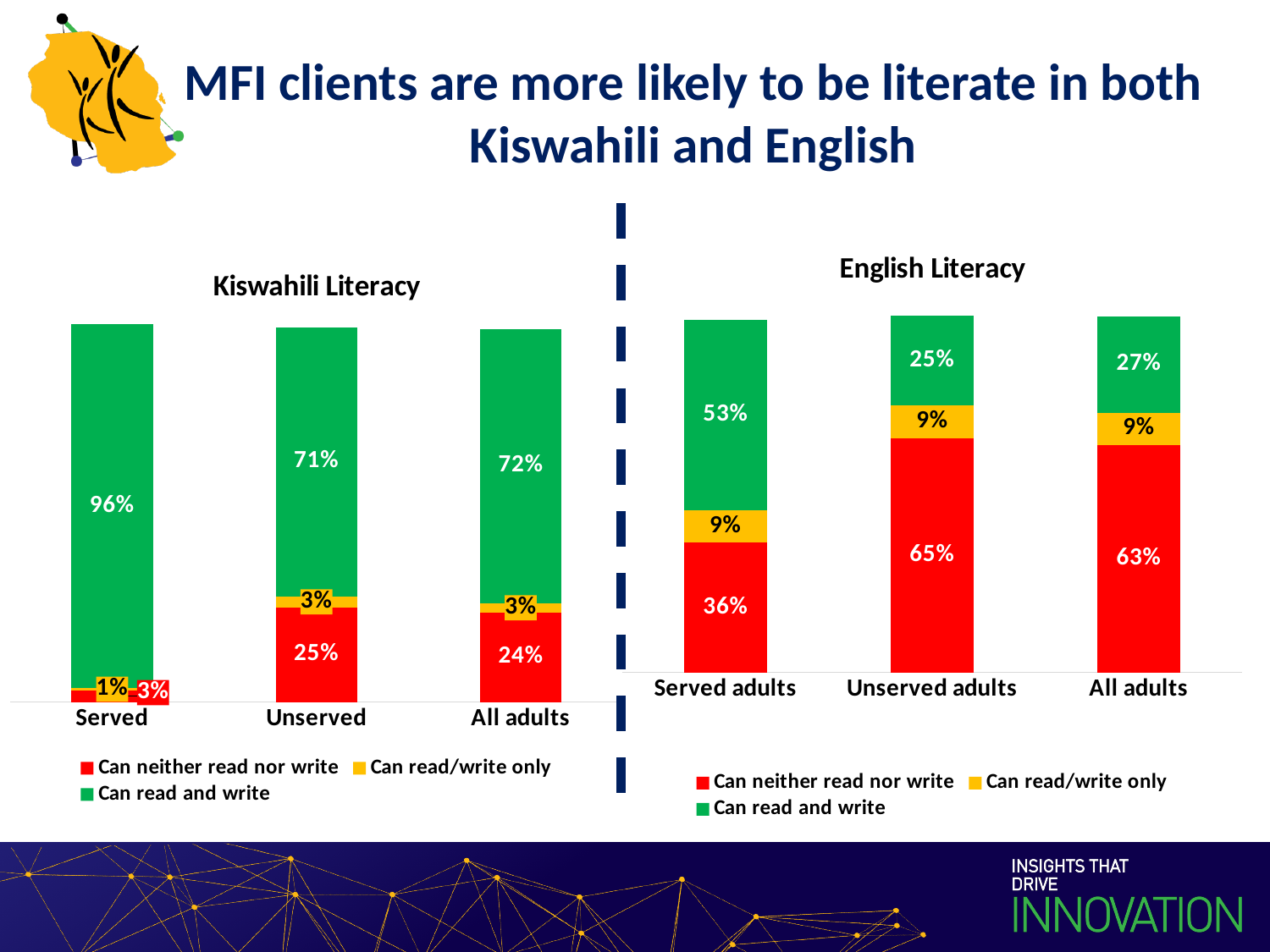
How many series does the legend of the Kiswahili Literacy chart list? 3 In the English Literacy chart, what percentage of Unserved adults can neither read nor write? 65% In the Kiswahili Literacy chart, which is larger: the share of Unserved adults who can neither read nor write or the share of All adults who can neither read nor write? Unserved In the Kiswahili Literacy chart, which category has the highest share that can read and write? Served In the Kiswahili Literacy chart, what percentage of Served adults can read and write? 96% In the English Literacy chart, what percentage of Served adults can read and write? 53% In the English Literacy chart, what is the difference between the share of Unserved adults and Served adults who can neither read nor write? 29% How many categories are shown on the x axis of the English Literacy chart? 3 In the Kiswahili Literacy chart, what percentage of Unserved adults can read and write? 71% In the English Literacy chart, which category has the lowest share that can neither read nor write? Served adults What type of chart is the English Literacy chart? Stacked bar chart In the English Literacy chart, what percentage of All adults can read/write only? 9%